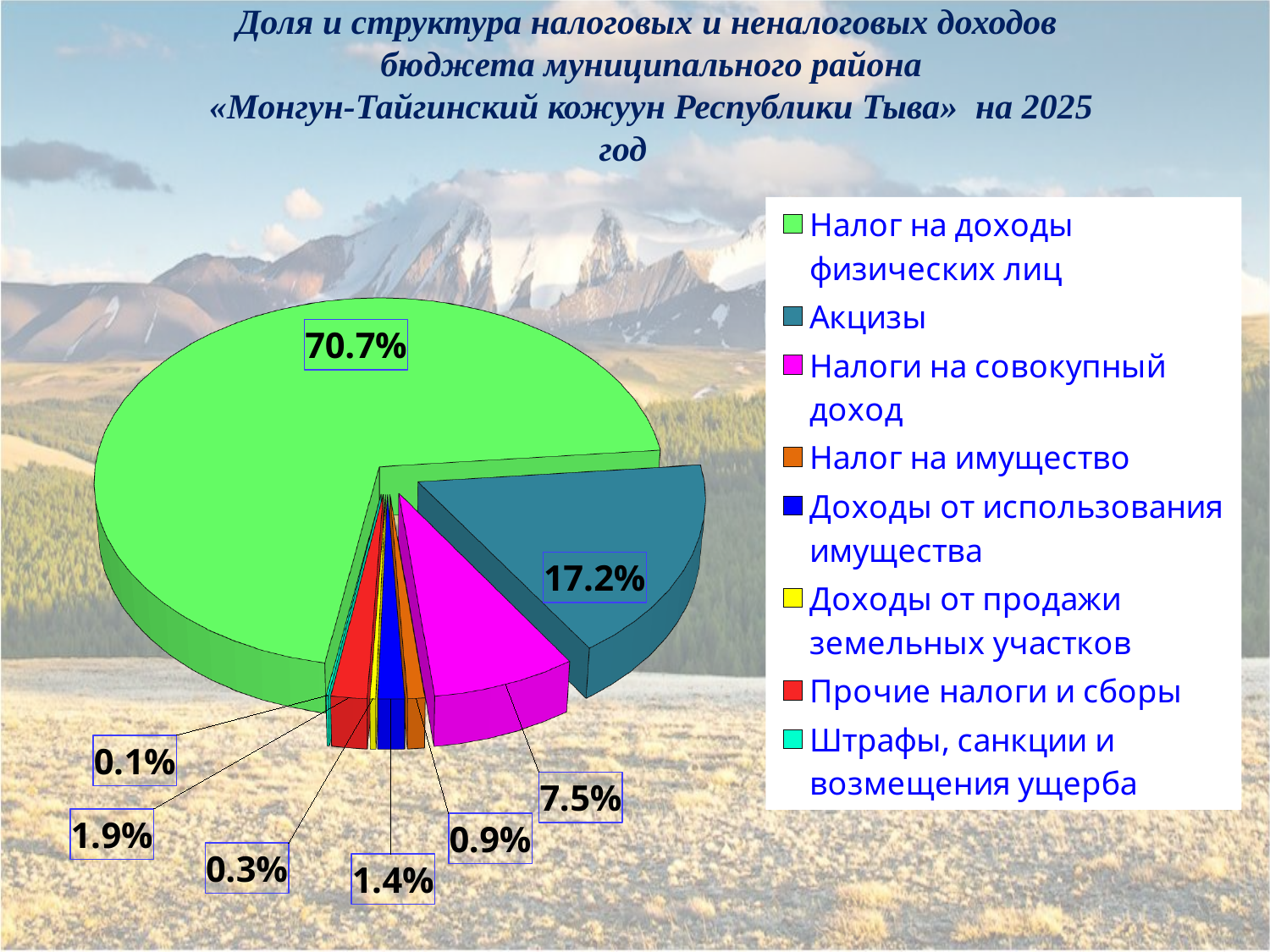
What is the value shown for "Доходы от использования имущества"? 1.4% What colour is the slice for "Акцизы"? teal What kind of chart is shown on the slide? pie chart What is the difference between the shares of "Налог на доходы физических лиц" and "Акцизы"? 53.5% What is the value shown for "Прочие налоги и сборы"? 1.9% Which category has the smallest share of the pie? Штрафы, санкции и возмещения ущерба Which category has the largest share of the pie? Налог на доходы физических лиц What share of the pie does "Налог на доходы физических лиц" have? 70.7% What is the value shown for "Акцизы"? 17.2% What is the value shown for "Налоги на совокупный доход"? 7.5% Which is larger: the share of "Налог на имущество" or the share of "Доходы от использования имущества"? Доходы от использования имущества How many entries does the legend list? 8